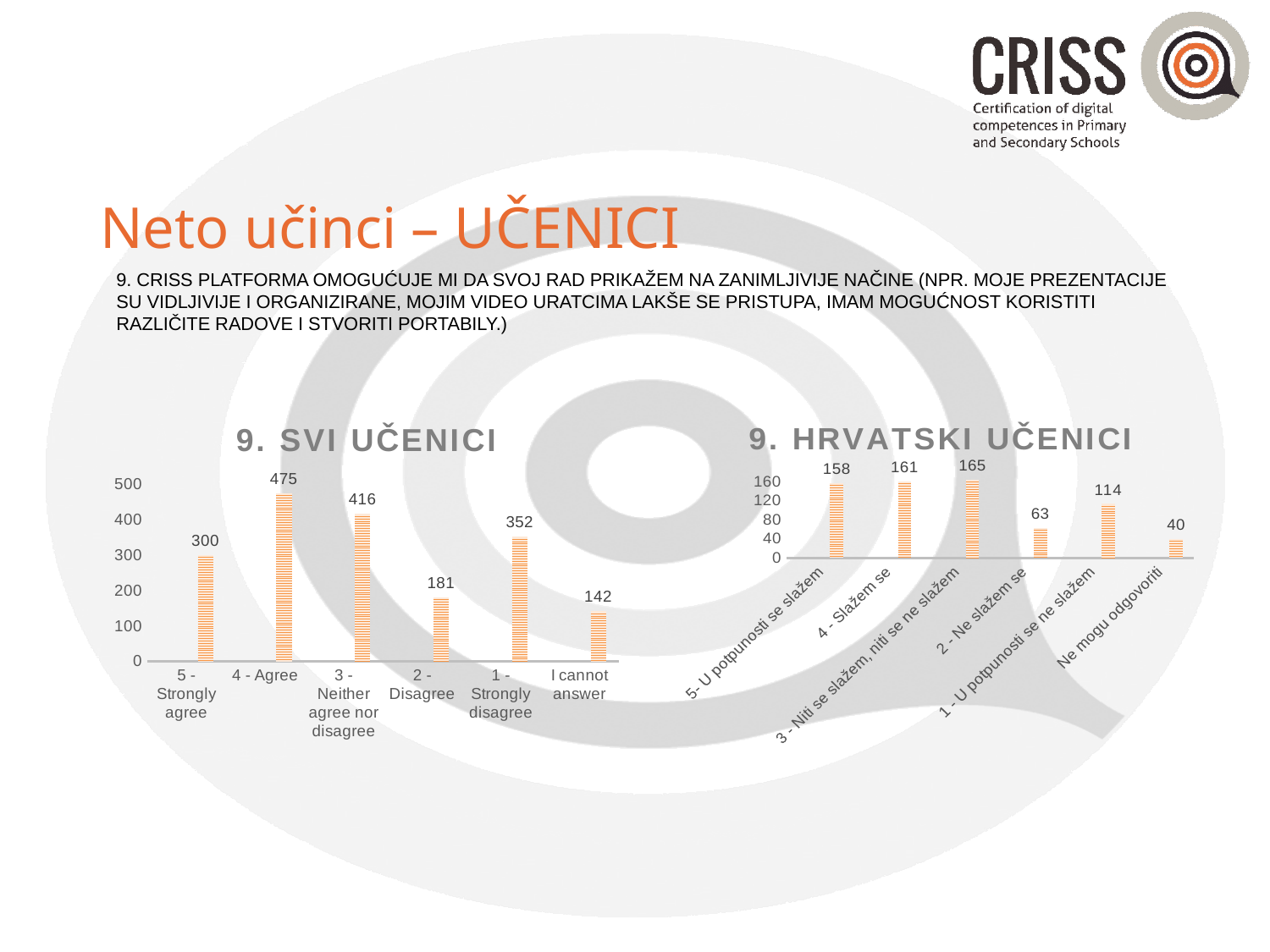
In the "9. SVI UČENICI" chart, which category has the highest value? 4 - Agree What kind of chart is the "9. SVI UČENICI" chart? Bar chart In the "9. SVI UČENICI" chart, which category has the lowest value? I cannot answer In the "9. HRVATSKI UČENICI" chart, which category has the lowest value? Ne mogu odgovoriti In the "9. HRVATSKI UČENICI" chart, what is the value for "2 - Ne slažem se"? 63 In the "9. SVI UČENICI" chart, what is the difference between "3 - Neither agree nor disagree" and "2 - Disagree"? 235 In the "9. SVI UČENICI" chart, what is the value for "I cannot answer"? 142 In the "9. HRVATSKI UČENICI" chart, which category has the highest value? 3 - Niti se slažem, niti se ne slažem In the "9. HRVATSKI UČENICI" chart, what is the difference between "5 - U potpunosti se slažem" and "Ne mogu odgovoriti"? 118 In the "9. SVI UČENICI" chart, what is the value for "4 - Agree"? 475 In the "9. HRVATSKI UČENICI" chart, which is larger: the value for "1 - U potpunosti se ne slažem" or the value for "2 - Ne slažem se"? 1 - U potpunosti se ne slažem In the "9. SVI UČENICI" chart, how many categories are shown on the x axis? 6